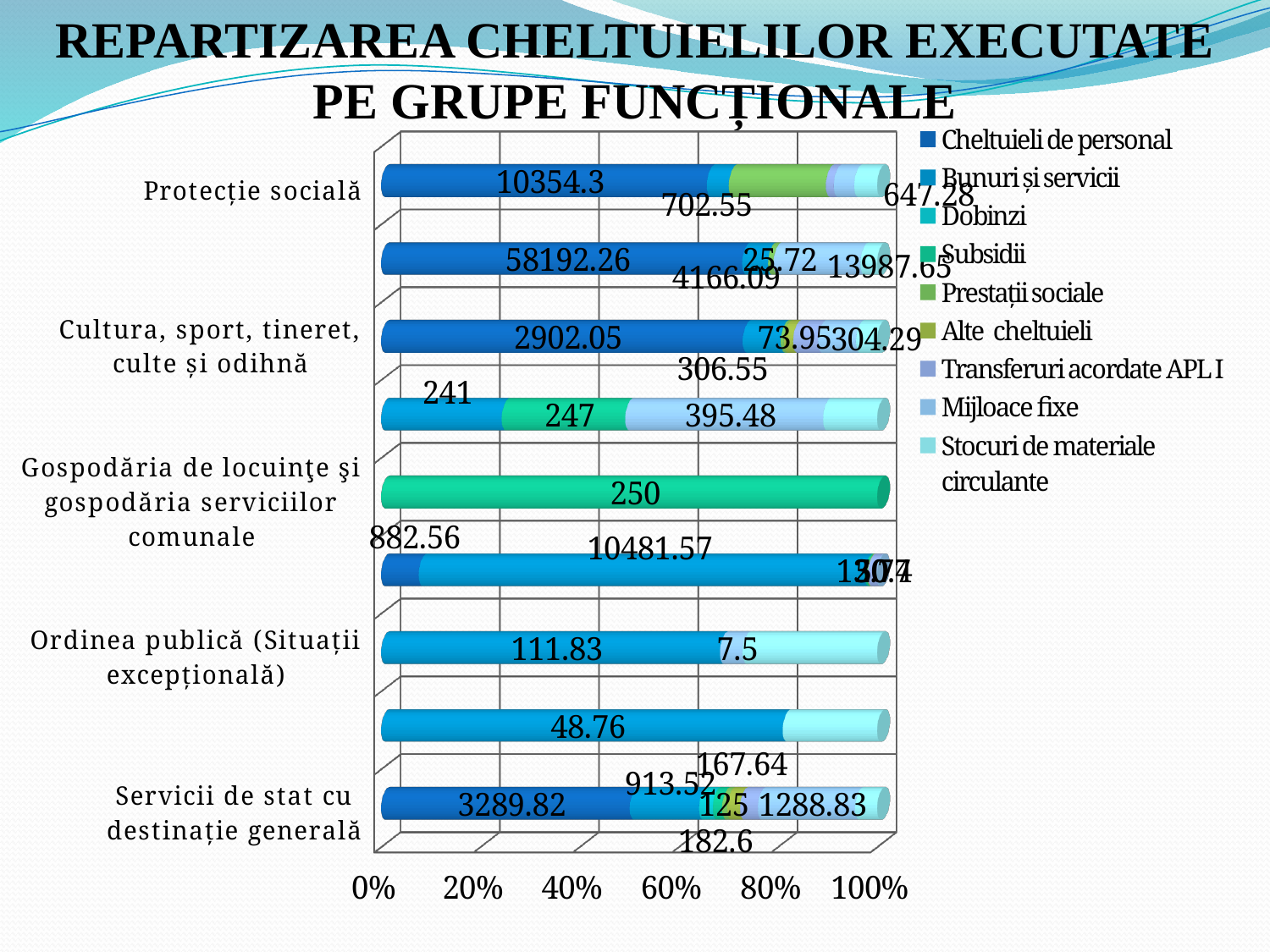
What is the value of Cheltuieli de personal for Cultura, sport, tineret, culte și odihnă? 2902.05 Is the share of Cheltuieli de personal in the Servicii de stat cu destinație generală bar greater or less than 60%? less How many series does the legend list? 9 How many bars are plotted in the chart? 9 What kind of chart is shown on the slide? bar chart What is the value of Cheltuieli de personal for Servicii de stat cu destinație generală? 3289.82 What is the value of Cheltuieli de personal for Protecție socială? 10354.3 Which is larger, Cheltuieli de personal for Protecție socială or for Servicii de stat cu destinație generală? Protecție socială What is the first entry listed in the legend? Cheltuieli de personal What value is printed on the bar for Gospodăria de locuinţe şi gospodăria serviciilor comunale? 250 What is the difference between Cheltuieli de personal for Protecție socială (10354.3) and for Servicii de stat cu destinație generală (3289.82)? 7064.48 What is the largest value printed on the bar for Ordinea publică (Situații excepțională)? 111.83